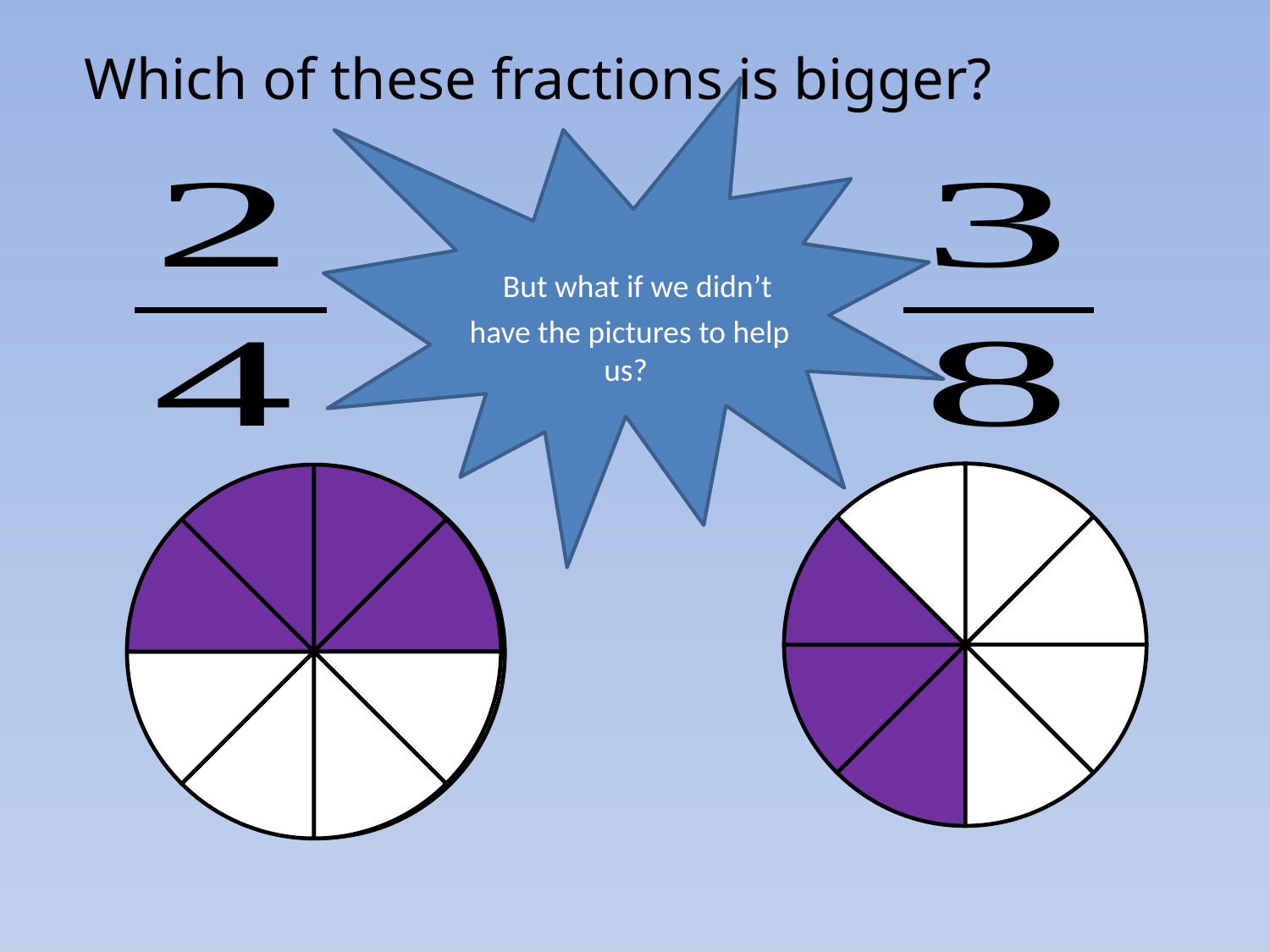
What fraction is written above the left circle? 2/4 What kind of chart is used to illustrate each fraction on the slide? pie chart What is the difference between the number of shaded slices in the left circle and the right circle? 1 What colour are the shaded slices in both circles? purple How many equal slices is the right circle divided into? 8 What fraction is written above the right circle? 3/8 Which circle has more purple-shaded slices, the left one or the right one? the left one How many slices of the left circle are shaded purple? 4 How many slices of the right circle are shaded purple? 3 What share of the right circle is shaded purple? 3/8 What share of the left circle is shaded purple? 4/8